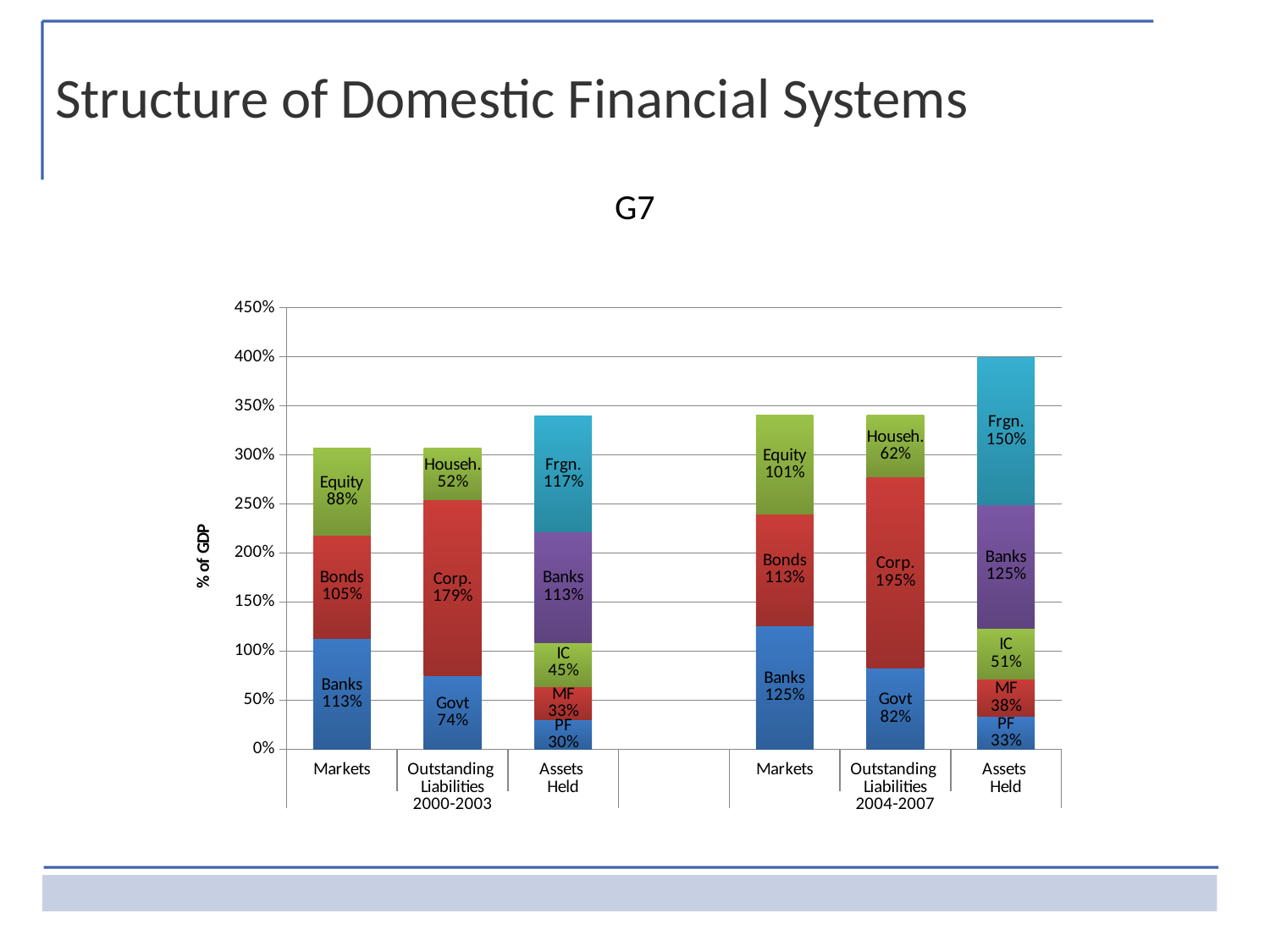
What kind of chart is shown on the slide? Stacked bar chart How many stacked bars are plotted on the chart? 6 What is the value of the Govt segment in the Outstanding Liabilities bar for 2000-2003? 74% What is the value of the Corp. segment in the Outstanding Liabilities bar for 2004-2007? 195% What is the total of the Assets Held bar for 2004-2007? 397% What is the value of the Banks segment in the Markets bar for 2000-2003? 113% What is the value of the Frgn. segment in the Assets Held bar for 2004-2007? 150% What is the label of the vertical axis? % of GDP Which bar on the chart is the tallest? Assets Held 2004-2007 What is the difference between the Corp. segment in 2004-2007 and the Corp. segment in 2000-2003? 16% What is the total of the Markets bar for 2000-2003? 306% Which is larger: the Equity segment in Markets for 2000-2003 or the Equity segment in Markets for 2004-2007? 2004-2007 (101%)